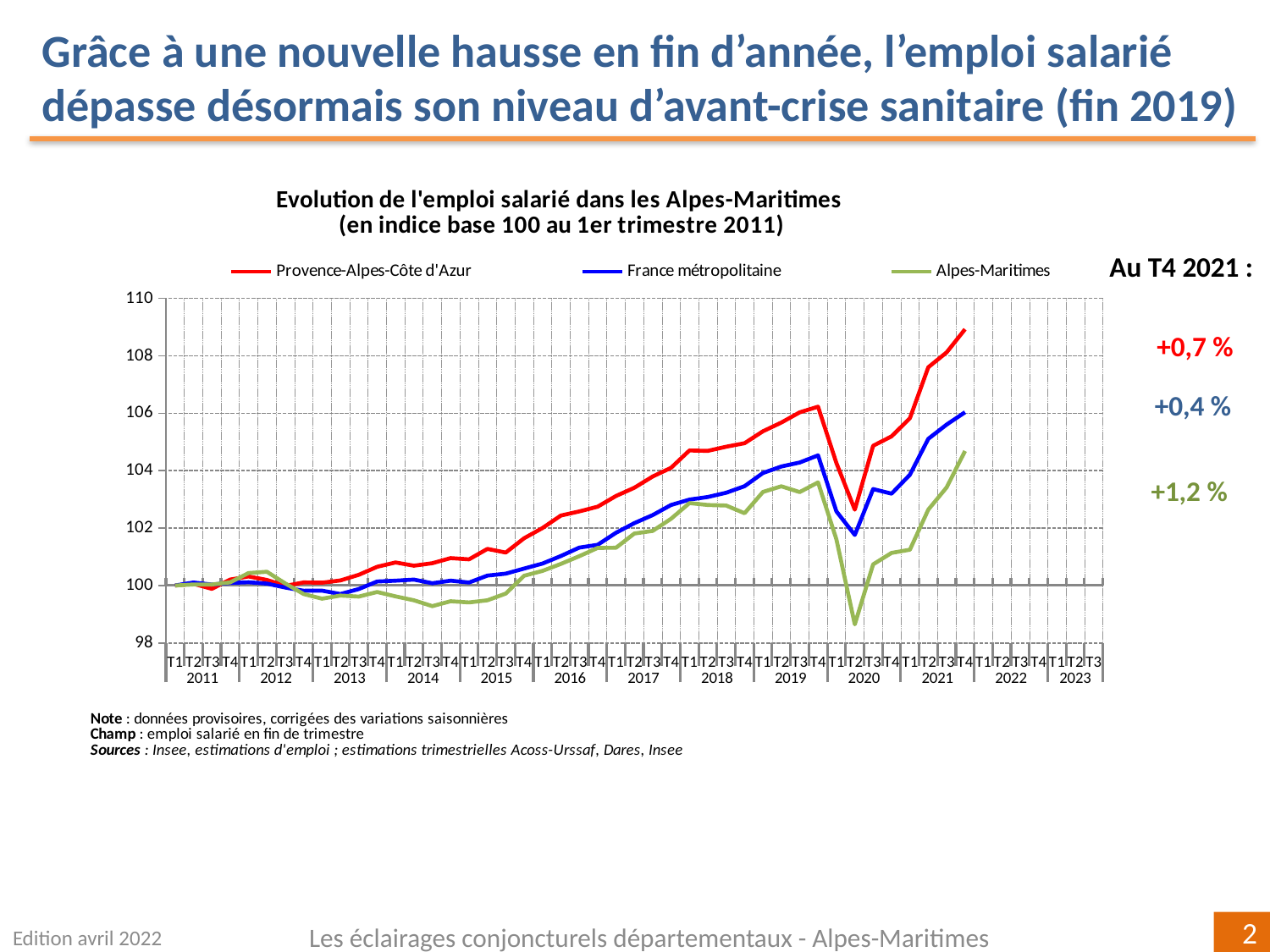
Between 2011 and 2019, does the Provence-Alpes-Côte d'Azur index generally rise or fall? rise Is the index value for Alpes-Maritimes at T2 2020 greater or less than 100? less Which series has the highest index value at T4 2021? Provence-Alpes-Côte d'Azur Which colour is used for the Alpes-Maritimes series in the chart? green Is the index value for Provence-Alpes-Côte d'Azur at T4 2021 greater or less than 108? greater According to the annotation on the right of the chart, what is the change at T4 2021 for Provence-Alpes-Côte d'Azur? +0,7 % According to the annotation on the right of the chart, what is the change at T4 2021 for Alpes-Maritimes? +1,2 % What is the title of the chart? Evolution de l'emploi salarié dans les Alpes-Maritimes (en indice base 100 au 1er trimestre 2011) How many series does the legend of the chart list? 3 Which series has the lowest index value at T2 2020? Alpes-Maritimes What type of chart is shown on the slide? line chart According to the annotation on the right of the chart, what is the change at T4 2021 for France métropolitaine? +0,4 %